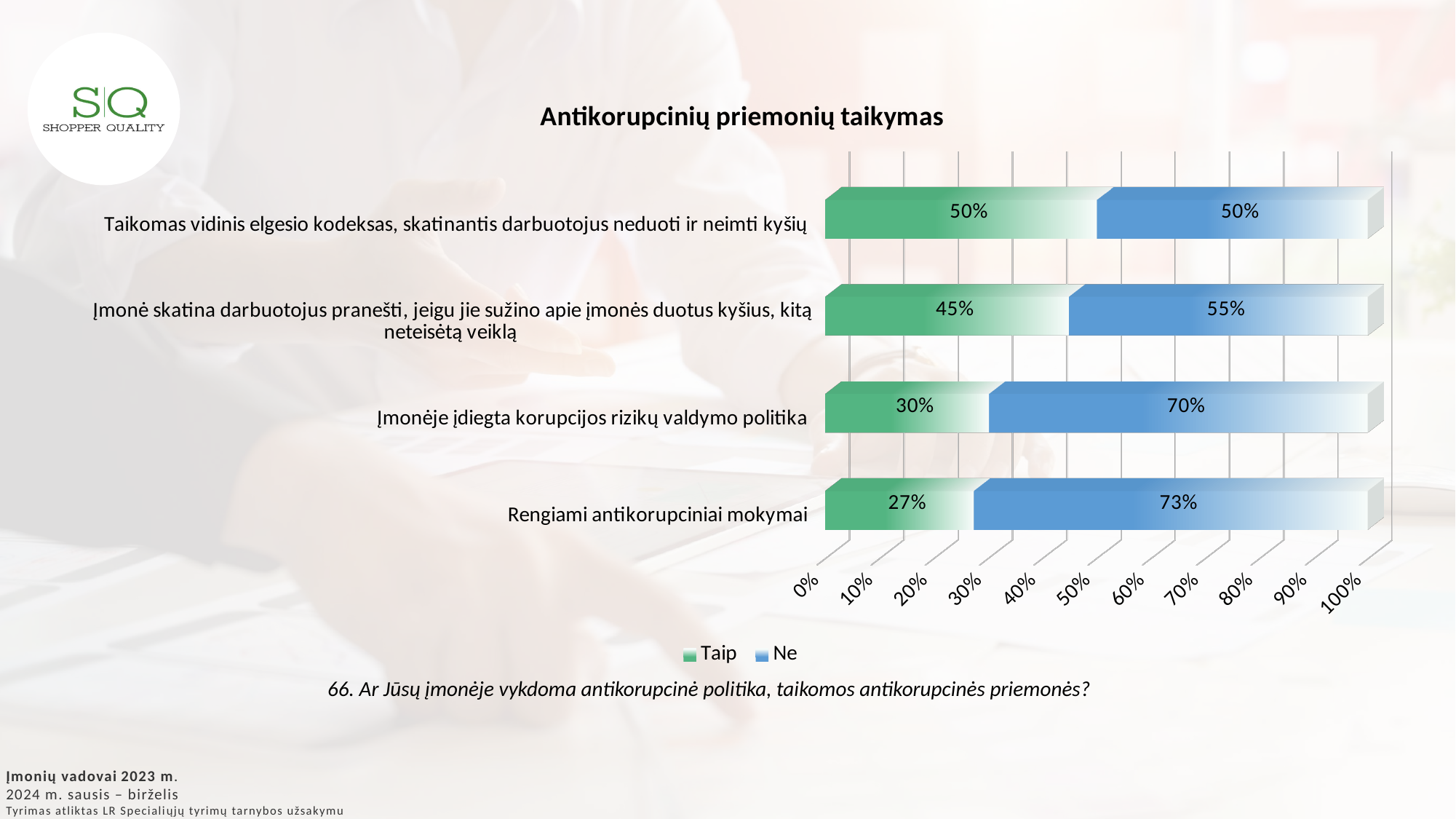
Which category has the highest 'Taip' value? Taikomas vidinis elgesio kodeksas, skatinantis darbuotojus neduoti ir neimti kyšių What kind of chart is shown on the slide? Stacked bar chart What is the title of the chart? Antikorupcinių priemonių taikymas What is the 'Taip' value for 'Įmonė skatina darbuotojus pranešti, jeigu jie sužino apie įmonės duotus kyšius, kitą neteisėtą veiklą'? 45% How many categories are shown in the chart? 4 Which category has the lowest 'Taip' value? Rengiami antikorupciniai mokymai What is the 'Ne' value for 'Įmonėje įdiegta korupcijos rizikų valdymo politika'? 70% What is the total of the stacked bar for 'Įmonėje įdiegta korupcijos rizikų valdymo politika'? 100% Which is larger for 'Įmonė skatina darbuotojus pranešti, jeigu jie sužino apie įmonės duotus kyšius, kitą neteisėtą veiklą': 'Taip' or 'Ne'? Ne What is the 'Taip' value for 'Rengiami antikorupciniai mokymai'? 27% What is the difference between the 'Ne' and 'Taip' values for 'Rengiami antikorupciniai mokymai'? 46% How many series does the legend list? 2